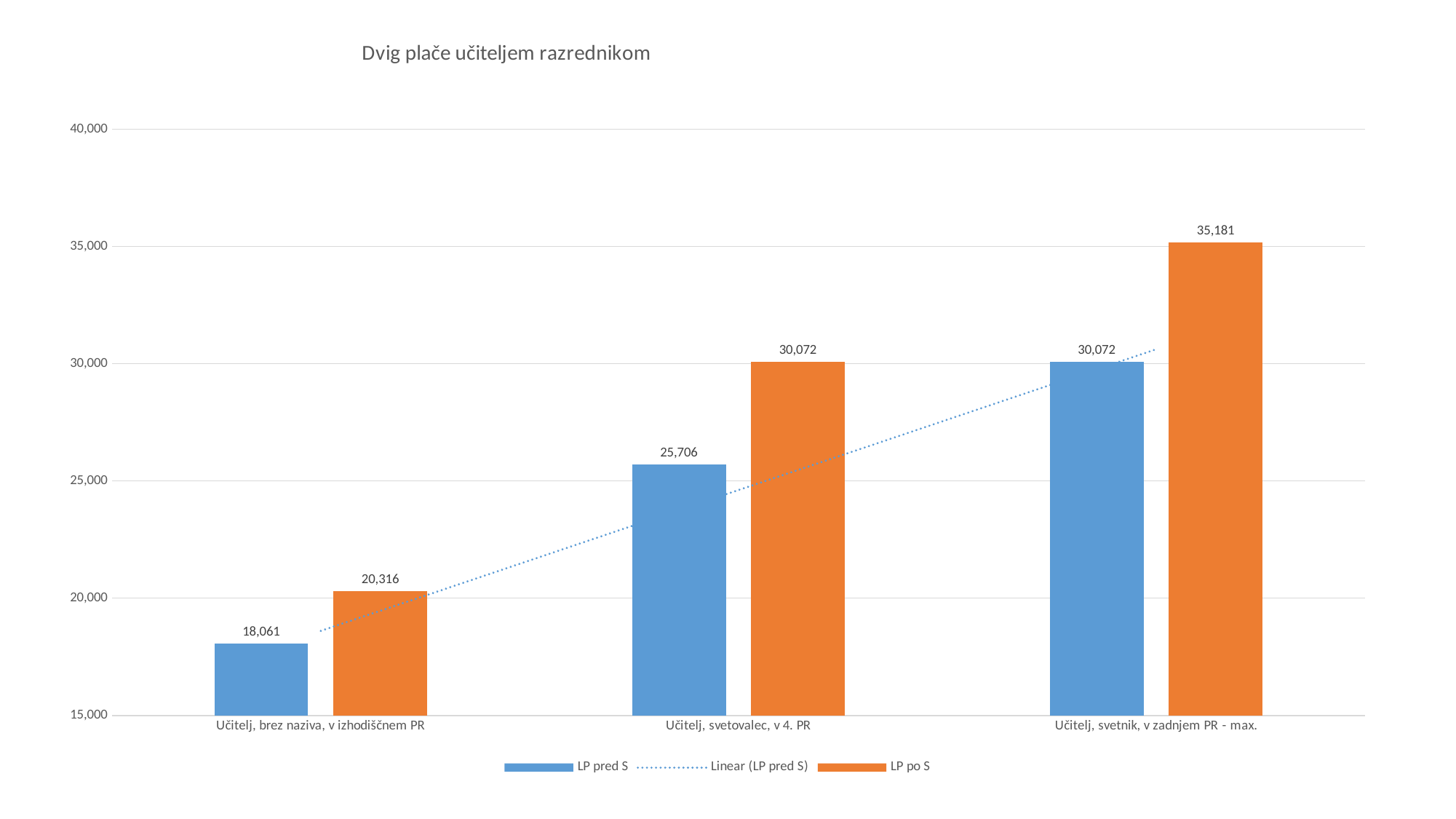
What is the value of LP po S for "Učitelj, svetovalec, v 4. PR"? 30,072 What kind of chart is this? Bar chart What is the difference between LP po S and LP pred S for "Učitelj, svetnik, v zadnjem PR - max."? 5,109 How many entries does the legend list? 3 What is the value of LP pred S for "Učitelj, brez naziva, v izhodiščnem PR"? 18,061 What is the difference between LP po S and LP pred S for "Učitelj, brez naziva, v izhodiščnem PR"? 2,255 What is the value of LP po S for "Učitelj, svetnik, v zadnjem PR - max."? 35,181 Which category has the lowest LP pred S value? Učitelj, brez naziva, v izhodiščnem PR Do the LP pred S values rise or fall from left to right across the categories? Rise Which is larger: LP pred S for "Učitelj, svetovalec, v 4. PR" or LP po S for "Učitelj, brez naziva, v izhodiščnem PR"? LP pred S for Učitelj, svetovalec, v 4. PR How many categories are shown on the x axis? 3 Which category has the highest LP po S value? Učitelj, svetnik, v zadnjem PR - max.